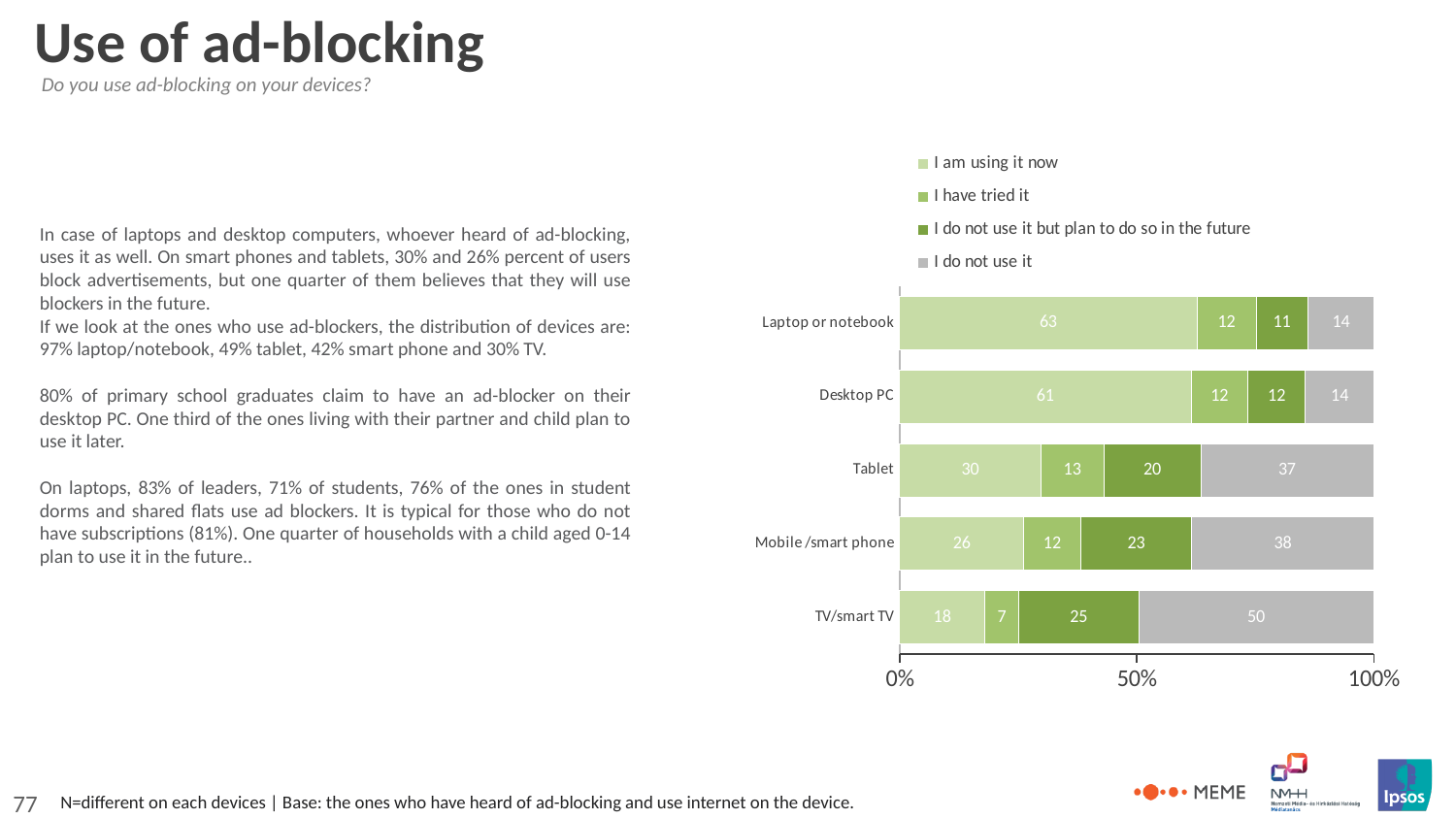
What is the value of "I do not use it" for TV/smart TV? 50 What kind of chart is shown on the slide? Stacked bar chart How many series does the legend list? 4 What is the difference between the "I do not use it" values for TV/smart TV and Tablet? 13 What is the value of "I have tried it" for Tablet? 13 What is the value of "I do not use it but plan to do so in the future" for Mobile /smart phone? 23 Which device has the highest value for "I am using it now"? Laptop or notebook What is the value of "I am using it now" for Laptop or notebook? 63 Which device has the lowest value for "I have tried it"? TV/smart TV How many device categories are plotted in the chart? 5 Which is larger: the "I am using it now" value for Tablet or for Mobile /smart phone? Tablet What is the last entry in the chart's legend? I do not use it